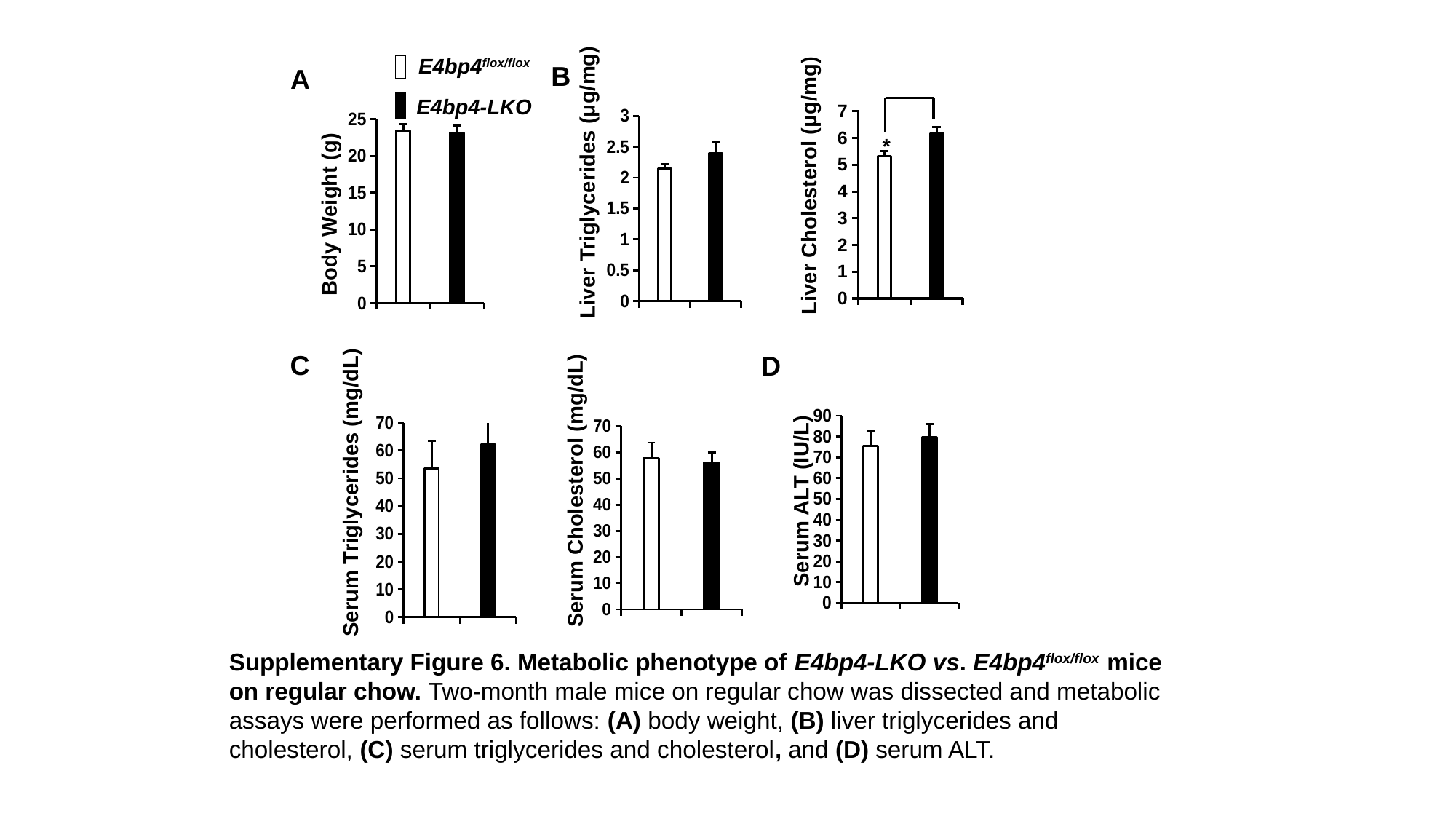
Which series is shown with black bars according to the legend? E4bp4-LKO What is the y-axis label of the chart in panel D? Serum ALT (IU/L) In the Serum Cholesterol chart (panel C), is the value for E4bp4-LKO greater or less than 50? greater In the Serum Triglycerides chart (panel C), is the value for E4bp4flox/flox greater or less than 60? less How many bars are plotted in the Liver Cholesterol chart in panel B? 2 In the Liver Cholesterol chart (panel B), is the value for E4bp4-LKO greater or less than 7? less How many series does the legend at the top of the slide list? 2 In the Serum Triglycerides chart (panel C), which series has the larger value, E4bp4flox/flox or E4bp4-LKO? E4bp4-LKO What kind of chart is the Body Weight chart in panel A? bar chart In the Liver Cholesterol chart (panel B), which series has the larger value, E4bp4flox/flox or E4bp4-LKO? E4bp4-LKO